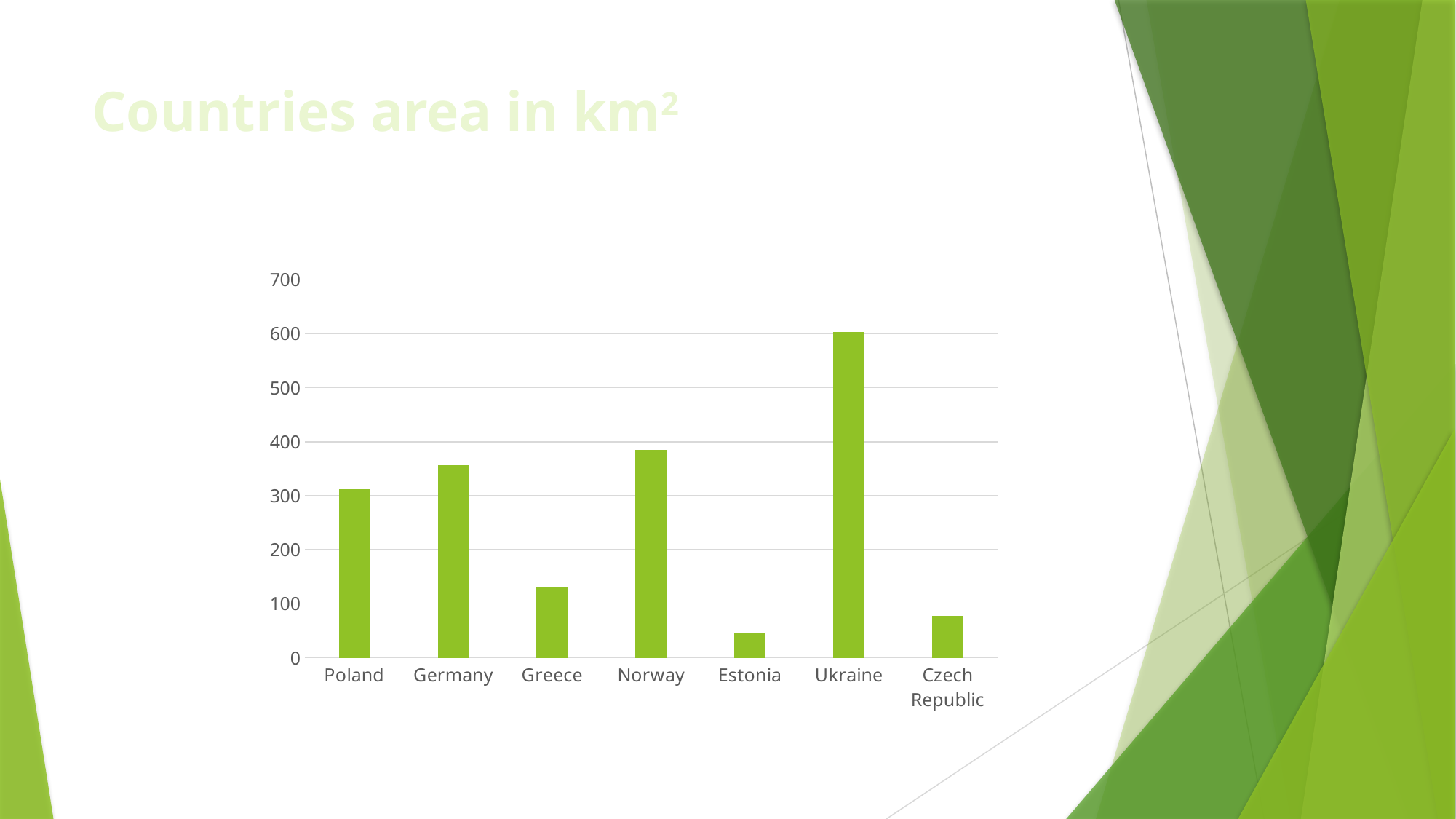
How many countries are shown in the chart? 7 Which is larger, the value for Germany or the value for Greece? Germany Is the value for Ukraine greater or less than 500? greater Is the value for Greece greater or less than 200? less Is the value for Czech Republic greater or less than 100? less What kind of chart is shown on the slide? bar chart Which country has the lowest value in the chart? Estonia Which country has the highest value in the chart? Ukraine What is the title of the slide? Countries area in km² Which is larger, the value for Norway or the value for Poland? Norway